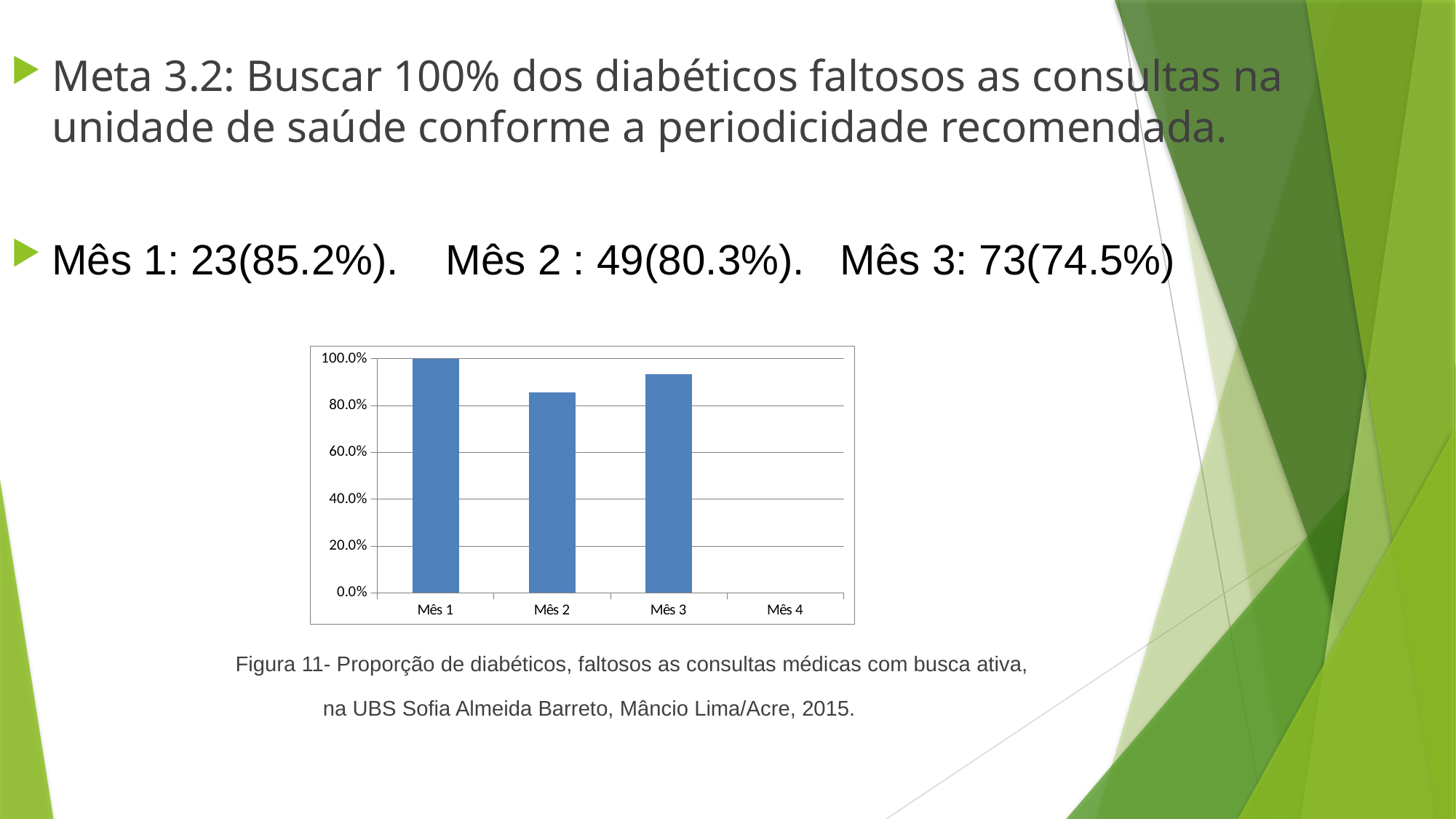
What colour are the bars in the chart? blue Among the months with a plotted bar, which has the lowest value? Mês 2 Is the value for Mês 2 greater or less than 80.0%? greater How many categories are labelled on the x axis of the chart? 4 Which month has the highest bar in the chart? Mês 1 Which month on the x axis has no bar plotted? Mês 4 What is the value of the bar for Mês 1 in the chart? 100.0% Is the value for Mês 3 greater or less than 100.0%? less Which bar is taller in the chart, Mês 2 or Mês 3? Mês 3 What kind of chart is shown on the slide? bar chart What is the highest value shown on the y axis of the chart? 100.0% How many bars are plotted in the chart? 3